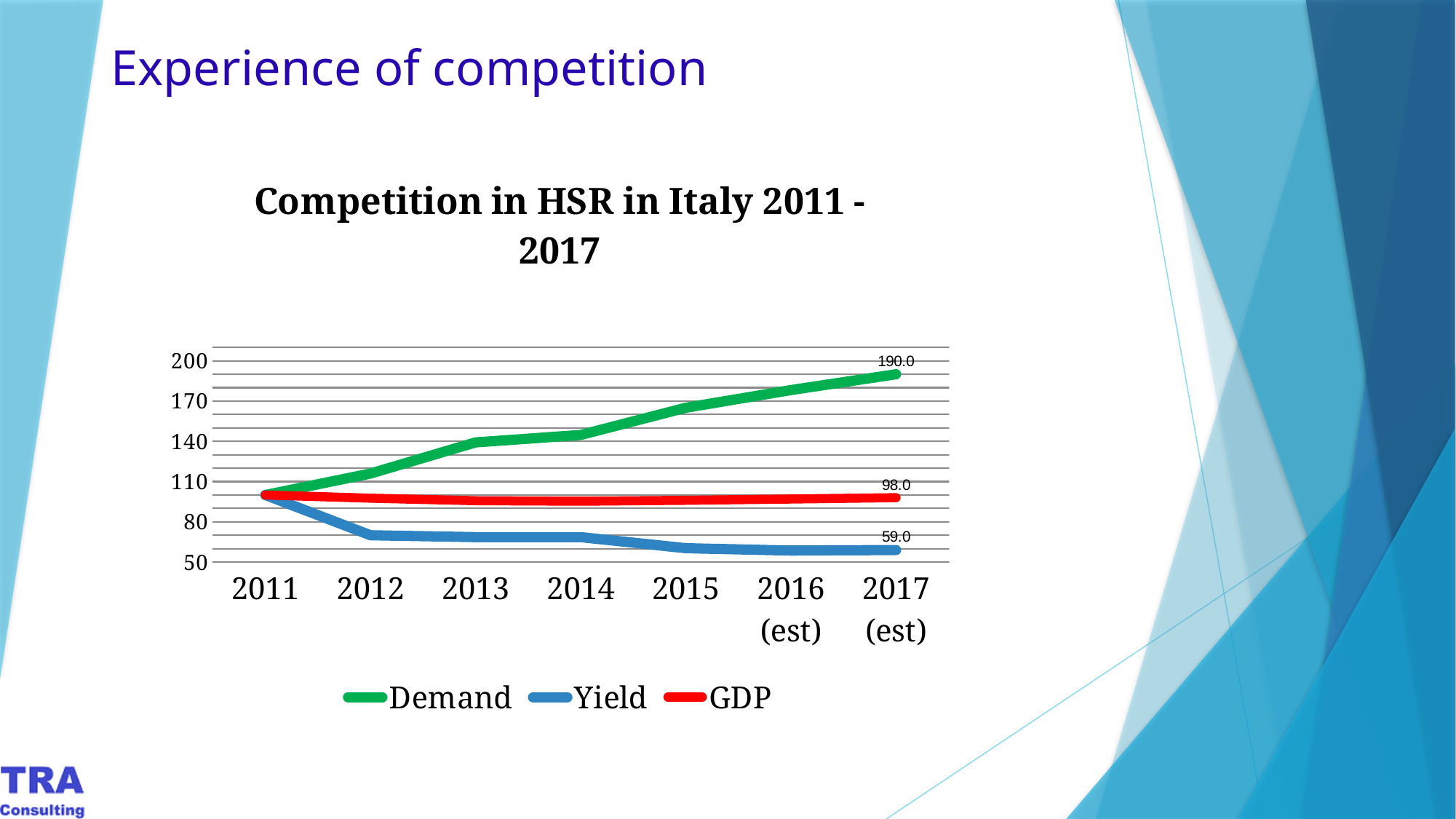
What is the difference between the GDP and Yield values in 2017 (est)? 39.0 What is the value of GDP in 2017 (est)? 98.0 What is the value of Yield in 2017 (est)? 59.0 What is the difference between the Demand and Yield values in 2017 (est)? 131.0 What is the value of Demand in 2017 (est)? 190.0 Is the value for Yield in 2013 greater or less than 80? less What kind of chart is shown on the slide? Line chart Which series has the highest value in 2017 (est)? Demand Does the Demand series rise or fall from 2011 to 2017 (est)? Rise Which series has the lowest value in 2017 (est)? Yield How many series does the legend list? 3